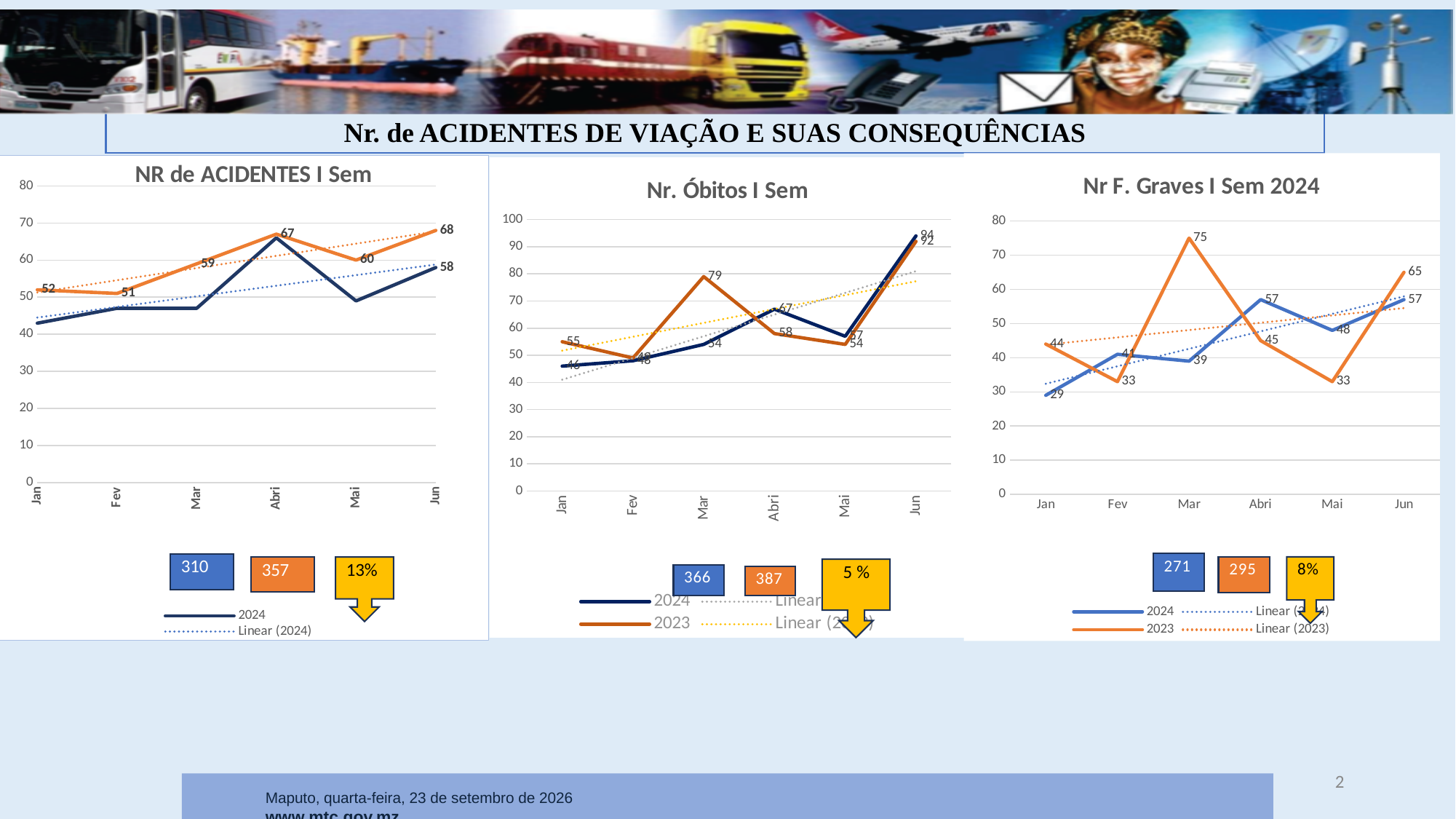
In the Nr. Óbitos I Sem chart, what is the 2024 value for Jun? 94 In the Nr F. Graves I Sem 2024 chart, in which month is the 2023 series highest? Mar In the Nr F. Graves I Sem 2024 chart, in which month is the 2024 series lowest? Jan In the Nr F. Graves I Sem 2024 chart, what is the difference between the 2023 and 2024 values for Jun? 8 In the Nr. Óbitos I Sem chart, what is the 2023 value for Mar? 79 In the Nr. Óbitos I Sem chart, what is the difference between the 2023 and 2024 values for Mar? 25 What kind of chart is the NR de ACIDENTES I Sem chart? Line chart In the Nr. Óbitos I Sem chart, how many entries does the legend list? 4 In the Nr F. Graves I Sem 2024 chart, what is the 2023 value for Mar? 75 In the Nr F. Graves I Sem 2024 chart, how many months are shown on the x axis? 6 In the Nr F. Graves I Sem 2024 chart, what is the 2024 value for Jan? 29 In the Nr. Óbitos I Sem chart, which series has the larger value in Jan, 2024 or 2023? 2023